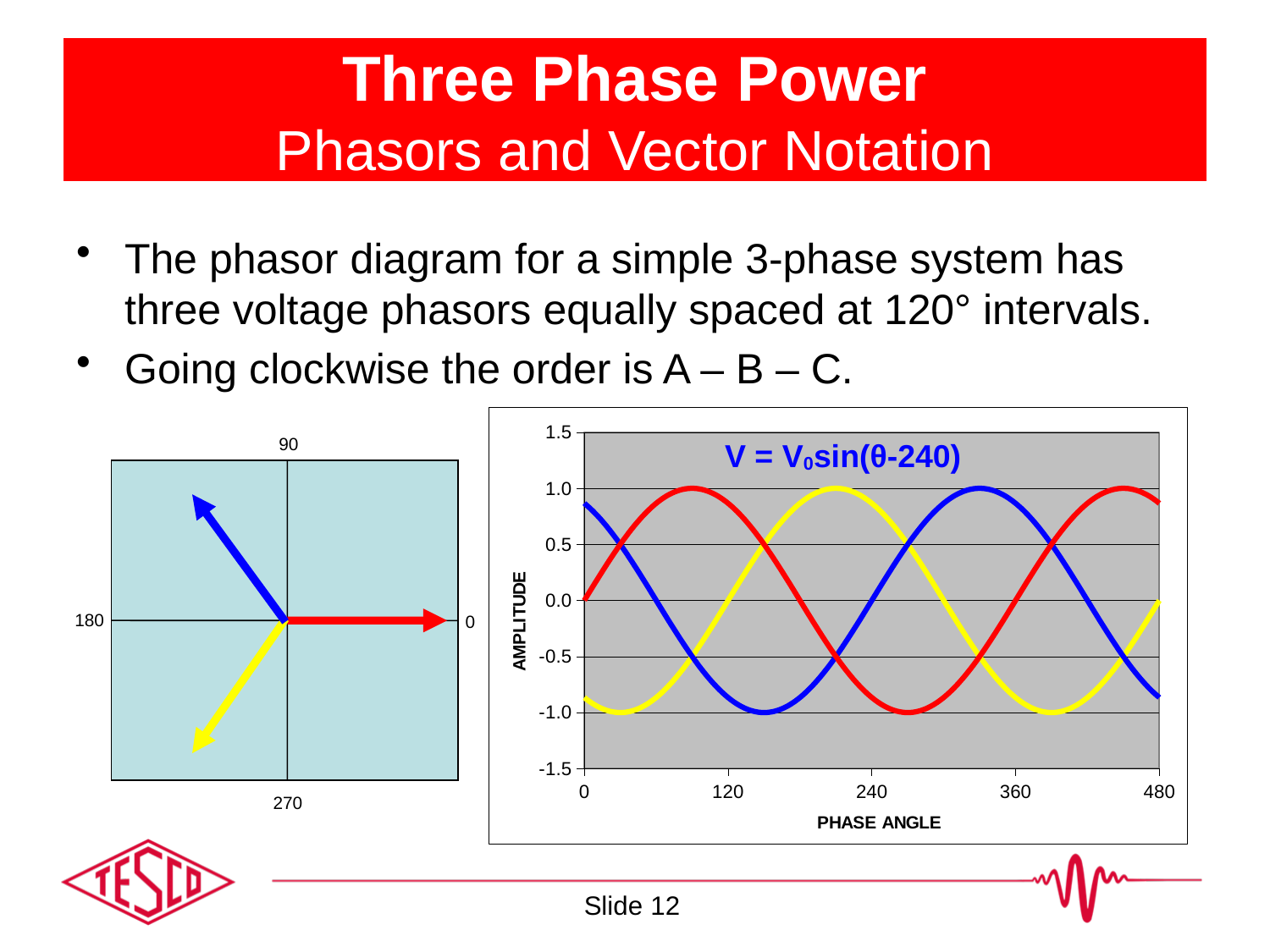
In the chart on the right, is the amplitude of the red curve at a phase angle of 120 greater or less than 0.5? greater What kind of chart is the chart on the right of the slide? line chart In the chart on the right, how many curves are plotted? 3 In the phasor diagram on the left, how many phasor arrows are drawn? 3 In the chart on the right, what is the lowest amplitude reached by the blue curve? -1.0 In the chart on the right, what is the label of the y axis? AMPLITUDE In the chart on the right, what is the largest phase angle shown on the x axis? 480 In the chart on the right, is the amplitude of the blue curve at a phase angle of 120 greater or less than -0.5? less In the chart on the right, what is the highest value shown on the y axis? 1.5 In the chart on the right, what is the peak amplitude reached by the red curve? 1.0 In the chart on the right, what is the label of the x axis? PHASE ANGLE In the chart on the right, what is the amplitude of the red curve at a phase angle of 0? 0.0